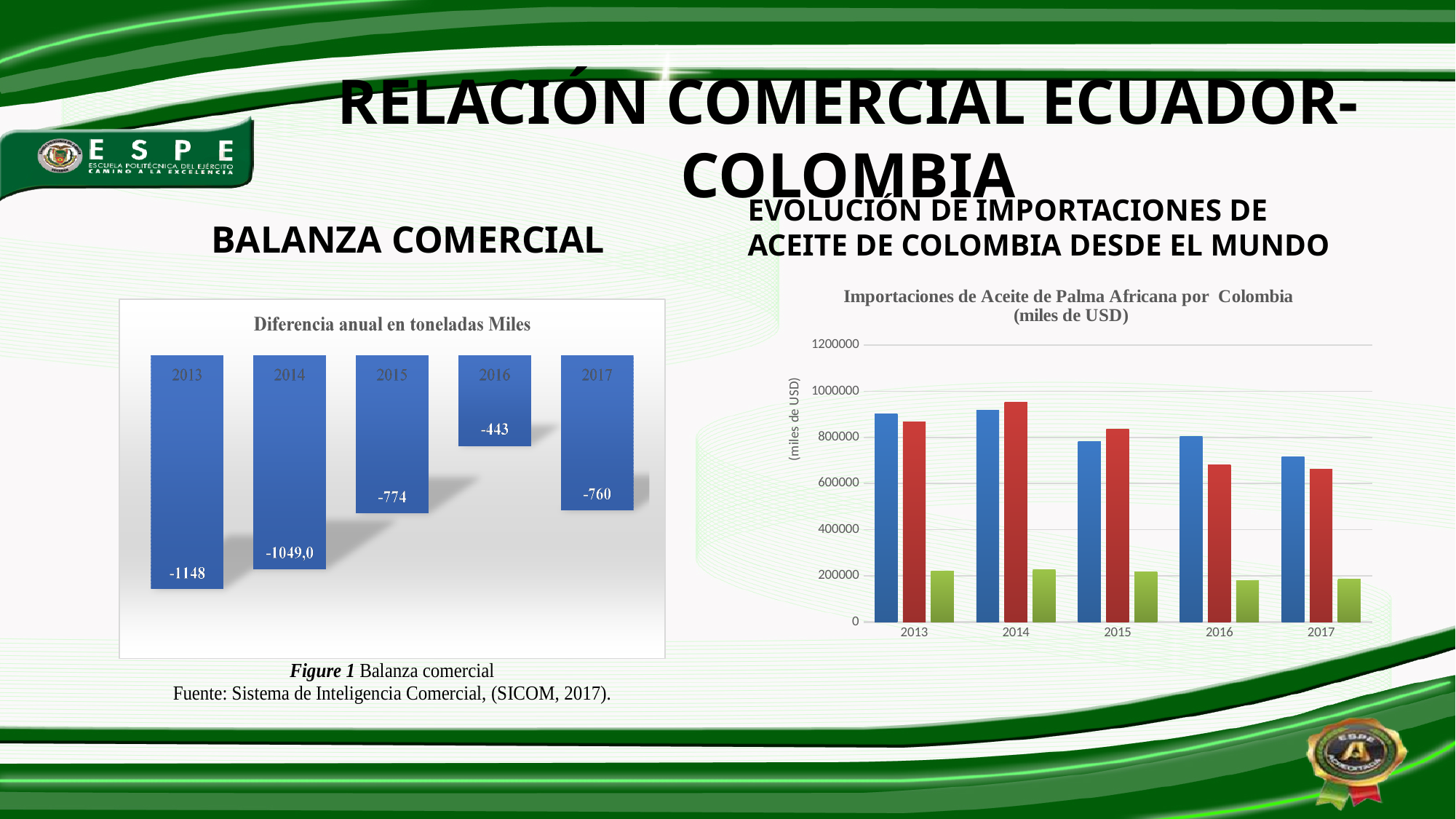
In the right chart 'Importaciones de Aceite de Palma Africana por Colombia', which is larger for 2014, the blue bar or the red bar? the red bar In the left chart 'Diferencia anual en toneladas Miles', which year has the highest (least negative) value? 2016 In the left chart 'Diferencia anual en toneladas Miles', what is the difference between the 2015 value and the 2016 value? 331 In the right chart 'Importaciones de Aceite de Palma Africana por Colombia', is the blue bar for 2013 greater or less than 800000? greater In the left chart 'Diferencia anual en toneladas Miles', how many years are shown? 5 In the left chart 'Diferencia anual en toneladas Miles', what is the value for 2013? -1148 In the left chart 'Diferencia anual en toneladas Miles', what is the value for 2014? -1049,0 In the left chart 'Diferencia anual en toneladas Miles', what is the value for 2017? -760 In the right chart 'Importaciones de Aceite de Palma Africana por Colombia', is the red bar for 2016 greater or less than 800000? less What type of chart is the right chart 'Importaciones de Aceite de Palma Africana por Colombia'? bar chart In the left chart 'Diferencia anual en toneladas Miles', which year has the lowest (most negative) value? 2013 In the left chart 'Diferencia anual en toneladas Miles', what is the value for 2016? -443